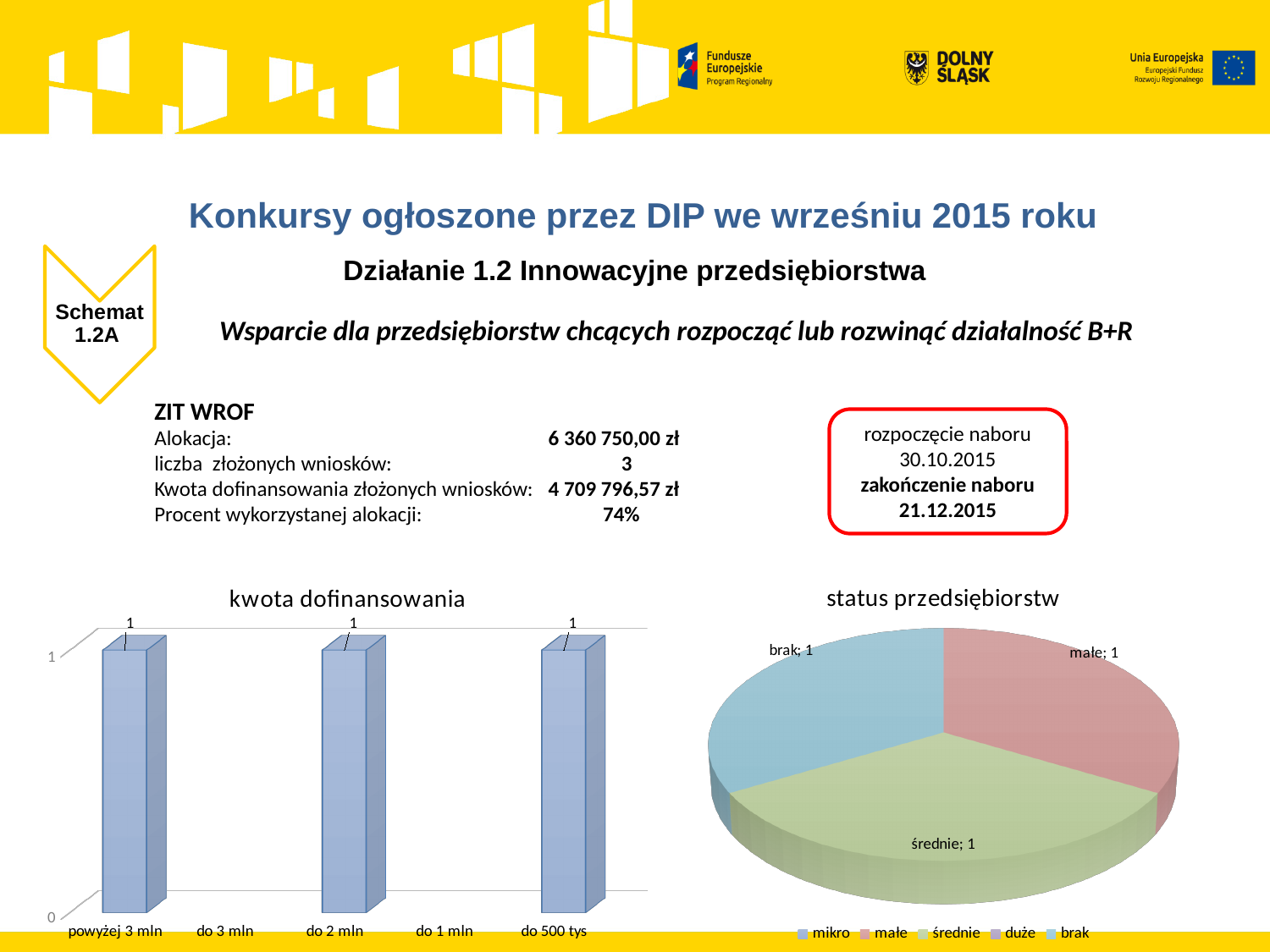
How many entries does the legend of the 'status przedsiębiorstw' chart list? 5 How many categories are shown on the x axis of the 'kwota dofinansowania' chart? 5 In the 'kwota dofinansowania' chart, what is the value for 'do 2 mln'? 1 What kind of chart is the 'status przedsiębiorstw' chart? pie chart In the 'status przedsiębiorstw' chart, what share of the pie does the 'małe' slice represent? 1/3 In the 'kwota dofinansowania' chart, what is the value for 'powyżej 3 mln'? 1 In the 'kwota dofinansowania' chart, what is the value for 'do 500 tys'? 1 What is the title of the pie chart on the right of the slide? status przedsiębiorstw In the 'status przedsiębiorstw' chart, what is the value for 'brak'? 1 What kind of chart is the 'kwota dofinansowania' chart? bar chart In the 'status przedsiębiorstw' chart, what is the value for 'małe'? 1 In the 'status przedsiębiorstw' chart, what is the value for 'średnie'? 1